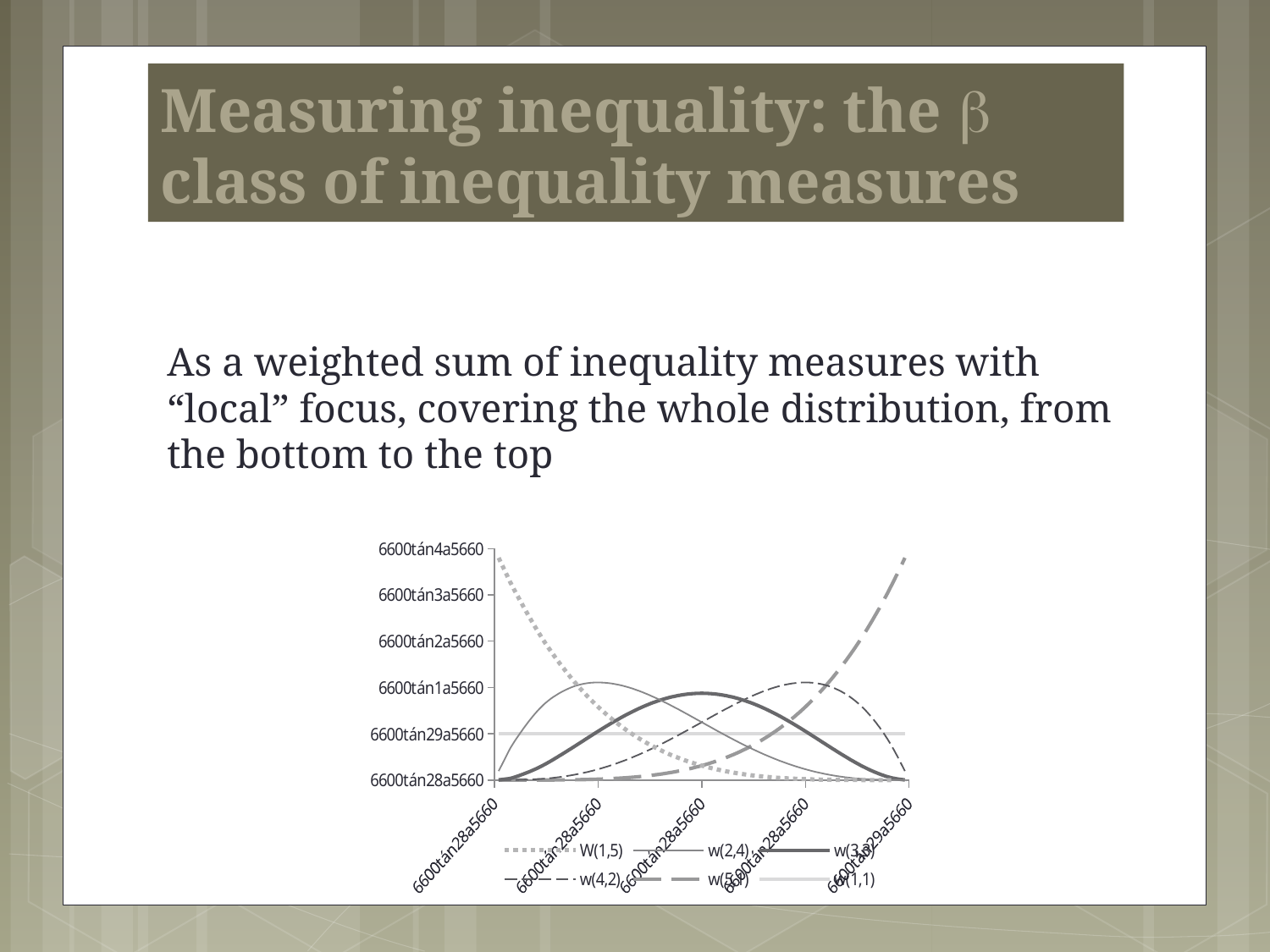
Does the w(2,4) series peak in the left half or the right half of the x axis? left half Which series is listed first in the chart's legend? W(1,5) What kind of chart is shown on the slide? line chart Does the W(1,5) series rise or fall as you move from left to right along the x axis? fall Does the w(5,1) series rise or fall as you move from left to right along the x axis? rise Which series in the chart is drawn as a flat horizontal line? w(1,1) How many series does the chart's legend list? 6